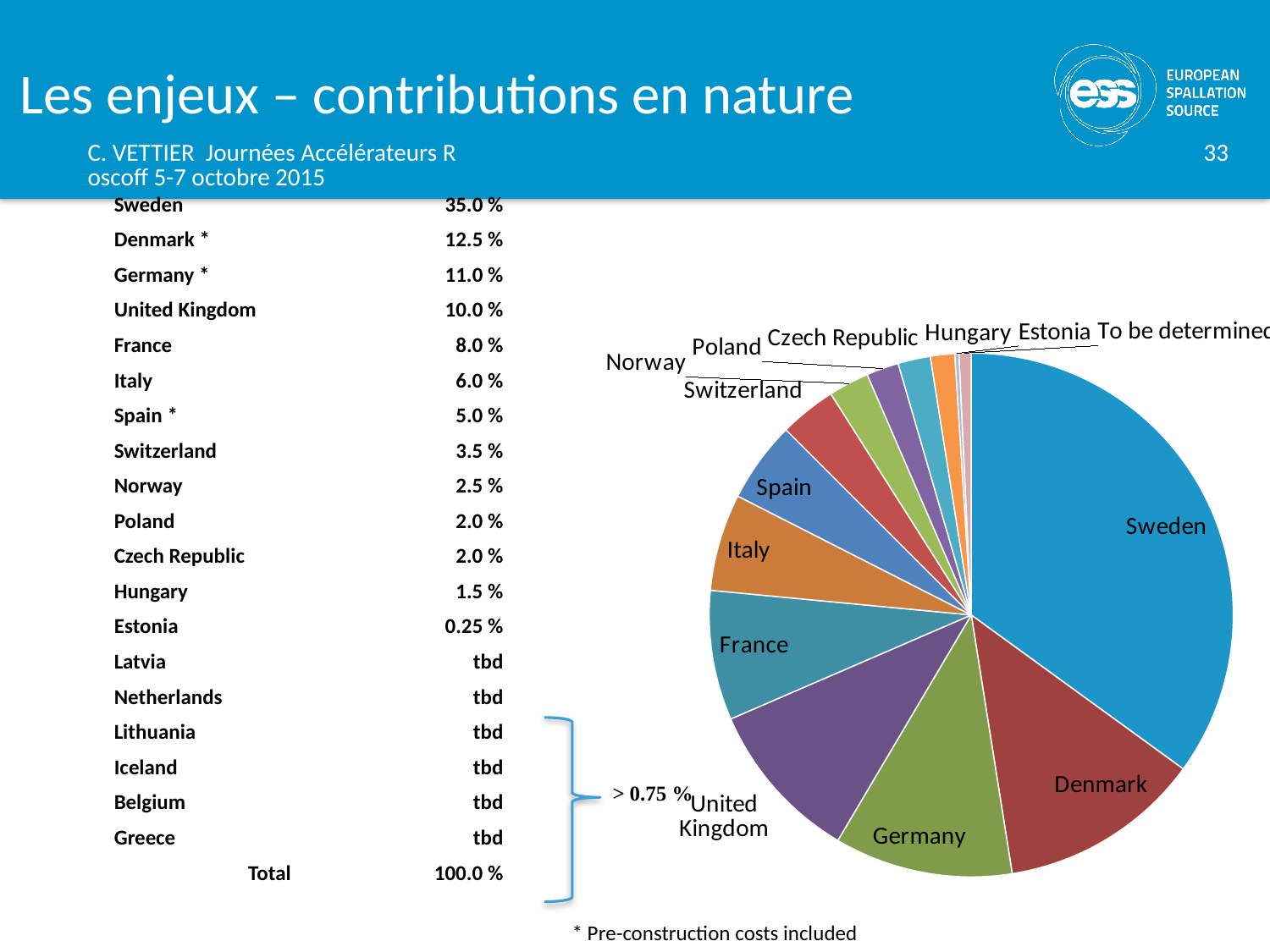
What is the contribution value for Sweden? 35.0 % What is the contribution value for France? 8.0 % What kind of chart is shown on the slide? pie chart Which slice is larger in the pie chart, United Kingdom or France? United Kingdom What is the contribution value for Switzerland? 3.5 % Which country has the largest slice of the pie chart? Sweden What is the label of the last slice in the pie chart, after Estonia? To be determined Which slice is larger in the pie chart, Sweden or Denmark? Sweden What share of the pie does Denmark represent? 12.5 % How many slices does the pie chart have? 14 What is the difference between the contributions of Sweden and Denmark? 22.5 % Which named country has the smallest slice in the pie chart? Estonia